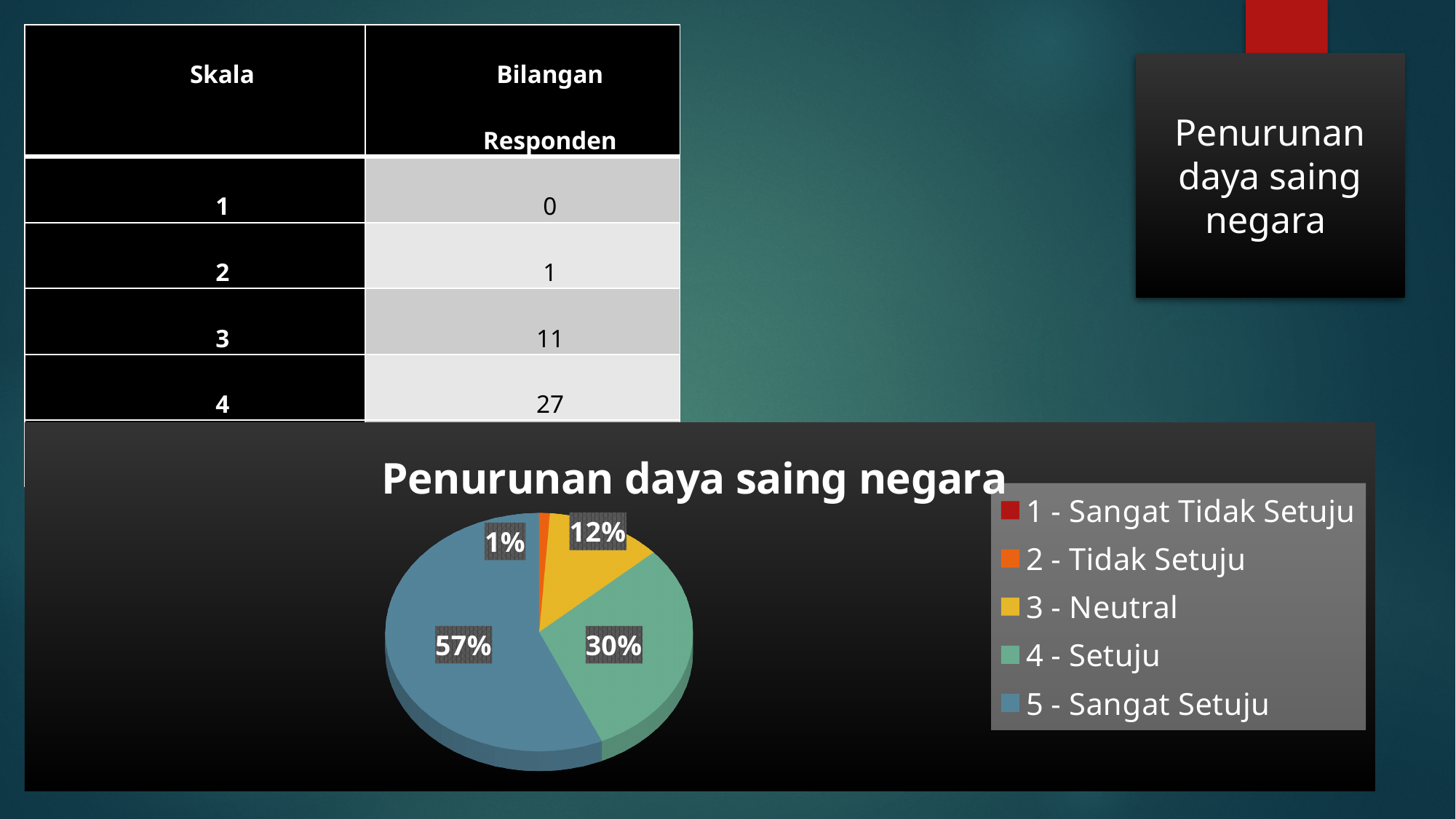
What kind of chart is shown on the slide? pie chart Which category with a visible slice has the smallest share of the pie? 2 - Tidak Setuju What share of the pie does the '5 - Sangat Setuju' slice represent? 57% What share of the pie does the '3 - Neutral' slice represent? 12% How many entries does the legend of the pie chart list? 5 What share of the pie does the '4 - Setuju' slice represent? 30% What colour is the '5 - Sangat Setuju' slice in the pie chart? blue What is the title of the pie chart? Penurunan daya saing negara Which category has the largest slice of the pie? 5 - Sangat Setuju Which slice is larger, '3 - Neutral' or '4 - Setuju'? 4 - Setuju What is the difference in percentage points between the '5 - Sangat Setuju' slice and the '4 - Setuju' slice? 27